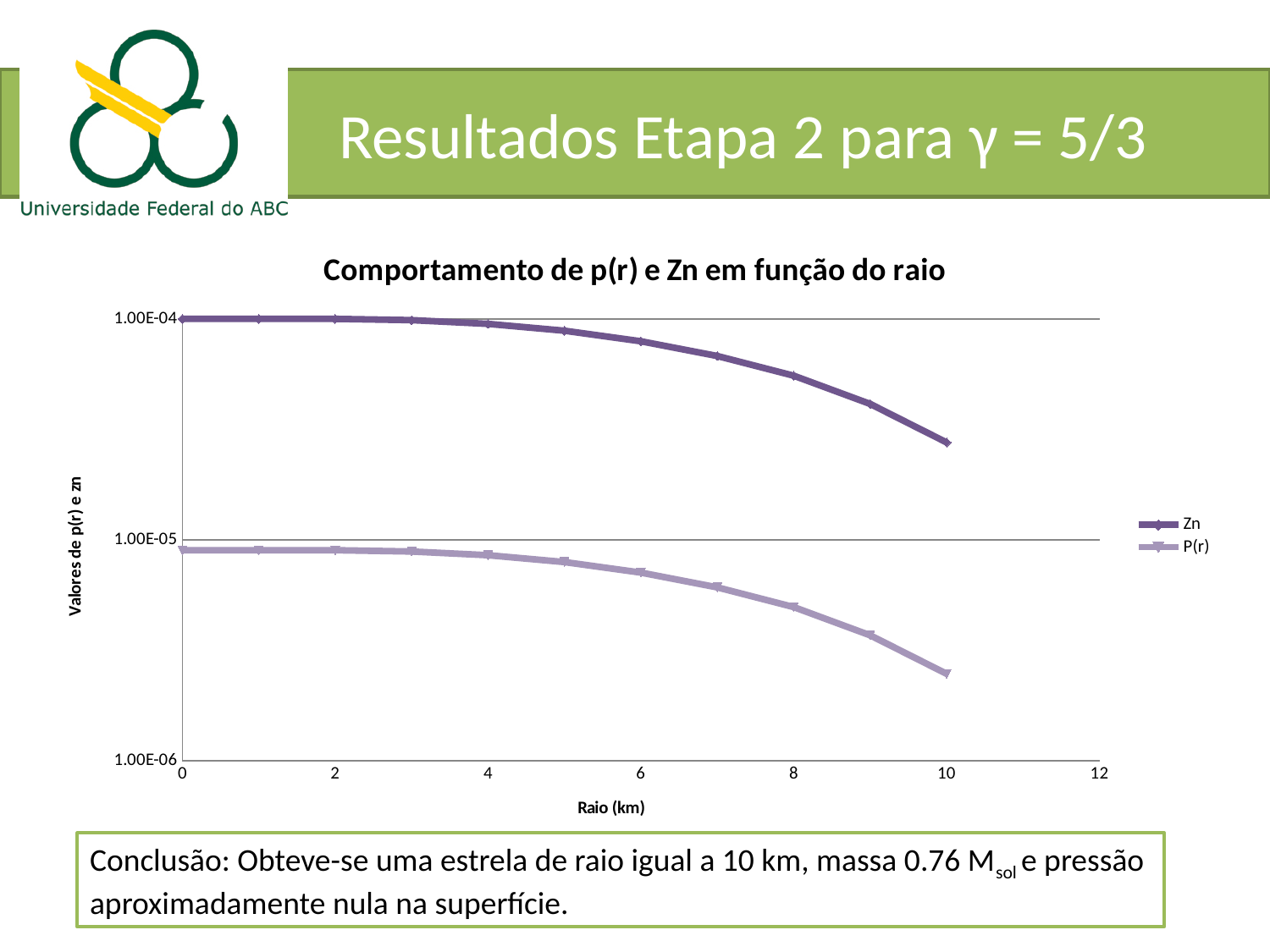
What are the two series named in the legend? Zn and P(r) What is the title of the chart? Comportamento de p(r) e Zn em função do raio Is the value of P(r) at a radius of 10 km greater or less than 1.00E-06? greater At a radius of 8 km, which series has the larger value, Zn or P(r)? Zn How many data points are plotted for the P(r) series? 11 Do the values of the Zn series rise or fall as the radius increases? fall Do the values of the P(r) series rise or fall as the radius increases? fall At which radius does the Zn series reach its lowest value? 10 Is the value of P(r) at a radius of 10 km greater or less than 1.00E-05? less How many series does the legend list? 2 Is the value of Zn at a radius of 10 km greater or less than 1.00E-04? less What kind of chart is shown on the slide? line chart